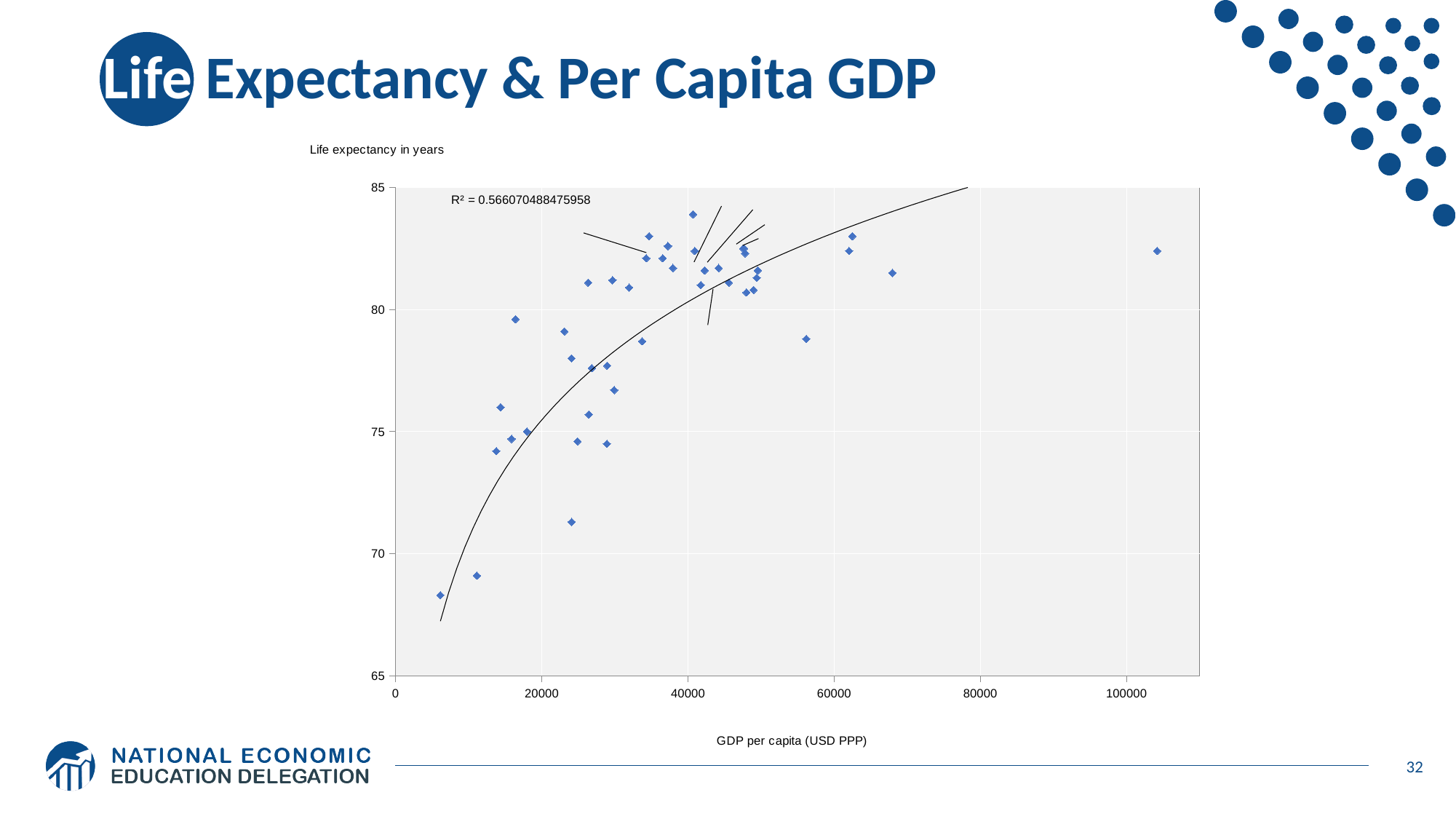
Is the life expectancy of the point with the highest life expectancy greater or less than 80? greater What kind of chart is shown on the slide? Scatter chart Is the life expectancy of the lowest point on the chart greater or less than 70? less What is the lowest value shown on the vertical axis? 65 Is the GDP per capita of the point with the lowest life expectancy greater or less than 20000? less What is the highest value shown on the vertical axis? 85 What is the title of the chart on the slide? Life Expectancy & Per Capita GDP What is the label of the horizontal axis of the chart? GDP per capita (USD PPP) What R² value is printed on the chart? R² = 0.566070488475958 Does life expectancy generally rise or fall as GDP per capita increases along the x axis? Rise